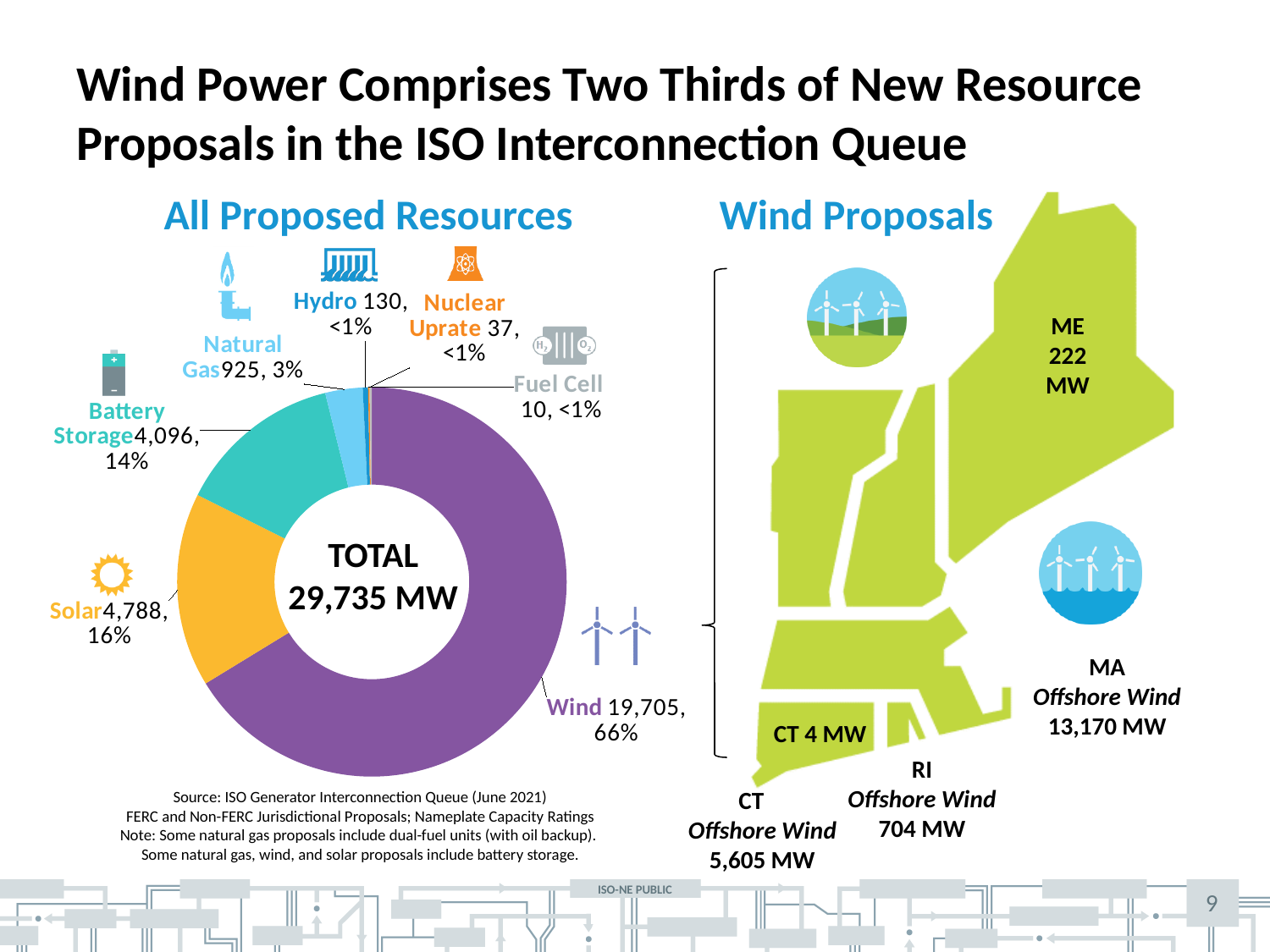
In the All Proposed Resources chart, what is the value for Natural Gas? 925 In the All Proposed Resources chart, which is larger, Solar or Battery Storage? Solar In the All Proposed Resources chart, what share of the total does Solar represent? 16% In the All Proposed Resources chart, which category has the largest value? Wind In the All Proposed Resources chart, what is the value for Solar? 4,788 In the All Proposed Resources chart, what is the difference between the Solar value and the Battery Storage value? 692 In the All Proposed Resources chart, what share of the total does Wind represent? 66% In the All Proposed Resources chart, what is the value for Battery Storage? 4,096 What kind of chart is the All Proposed Resources chart? doughnut chart In the All Proposed Resources chart, what is the value for Wind? 19,705 How many categories are shown in the All Proposed Resources chart? 7 In the All Proposed Resources chart, which category has the smallest value? Fuel Cell